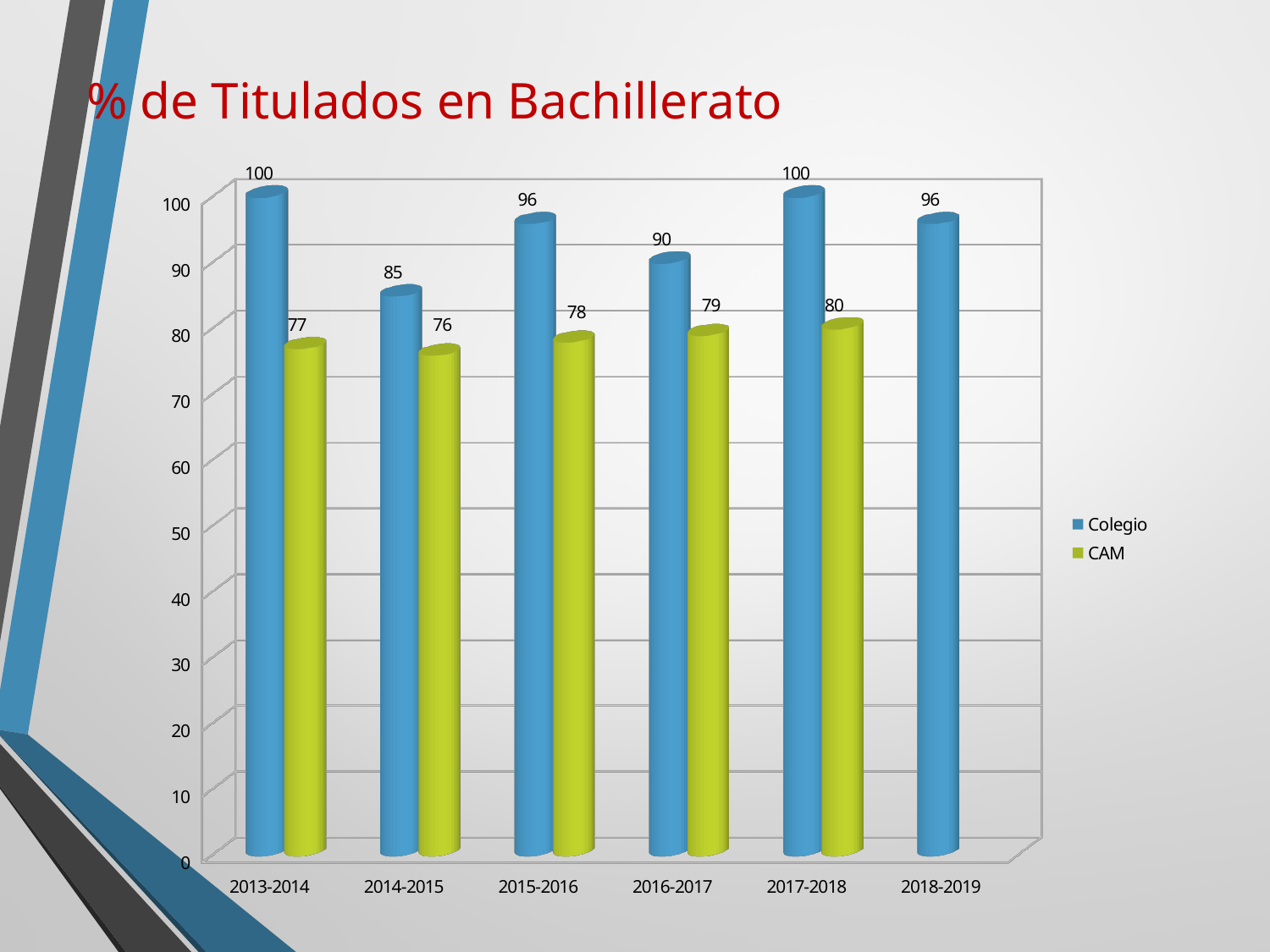
How many series does the legend list? 2 Which year has the lowest CAM value? 2014-2015 Which year has the lowest Colegio value? 2014-2015 Which is larger in 2015-2016, the Colegio value or the CAM value? Colegio What is the Colegio value for 2018-2019? 96 What is the title of the chart? % de Titulados en Bachillerato What is the difference between the Colegio and CAM values in 2013-2014? 23 What kind of chart is shown on the slide? Bar chart What is the Colegio value for 2014-2015? 85 What is the CAM value for 2017-2018? 80 What is the difference between the Colegio and CAM values in 2016-2017? 11 How many year categories are shown on the x axis? 6